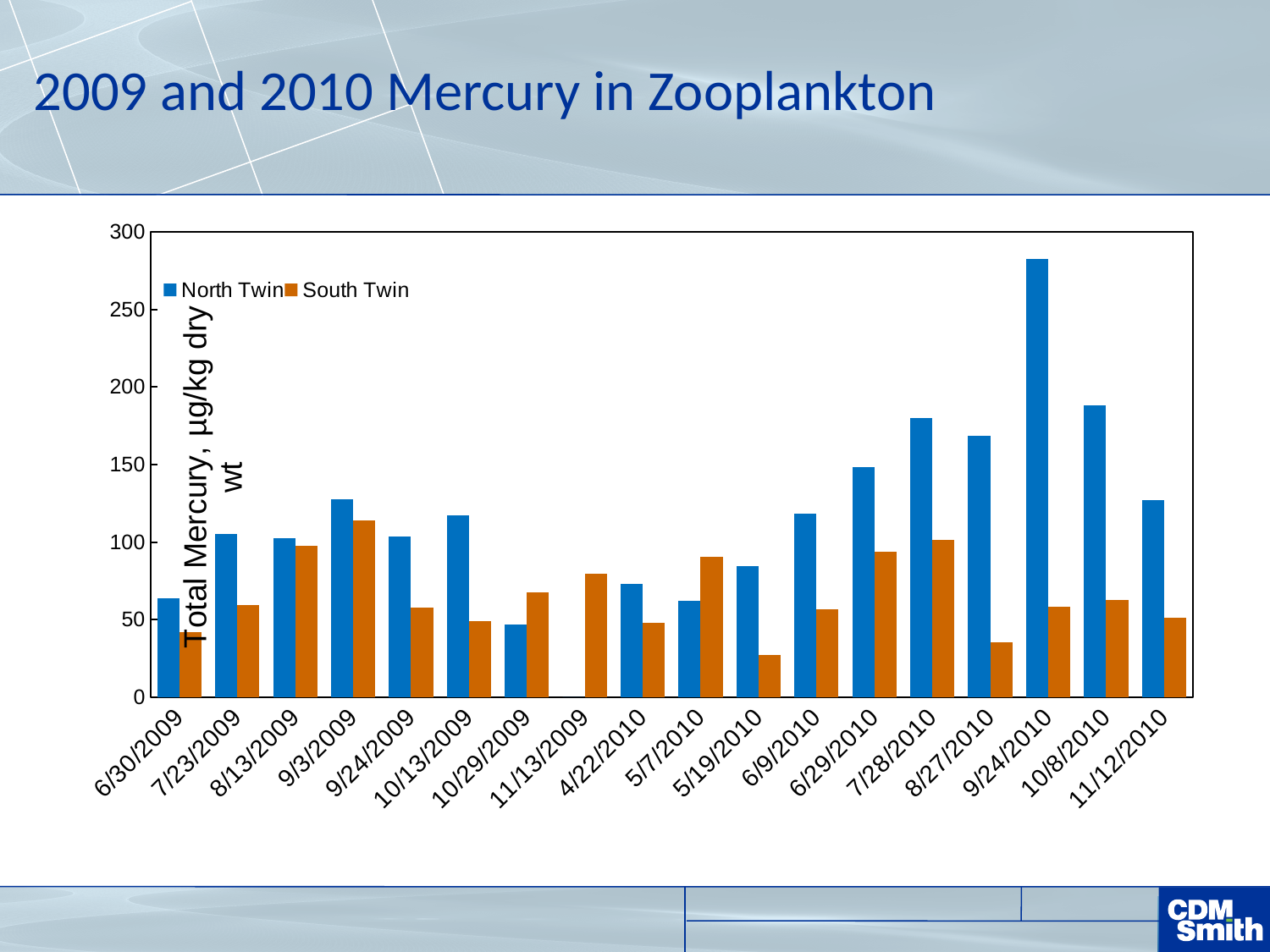
On which date is the South Twin value lowest? 5/19/2010 On which date is the North Twin value highest? 9/24/2010 On 5/7/2010, which series has the larger value, North Twin or South Twin? South Twin Is the North Twin value for 9/24/2010 greater or less than 250? greater On which date is the South Twin value highest? 9/3/2009 How many sampling dates are shown on the x axis? 18 What is the label on the y axis? Total Mercury, µg/kg dry wt Is the North Twin value for 7/28/2010 greater or less than 150? greater What kind of chart is shown on the slide? bar chart How many series does the legend list? 2 Is the South Twin value for 9/3/2009 greater or less than 100? greater